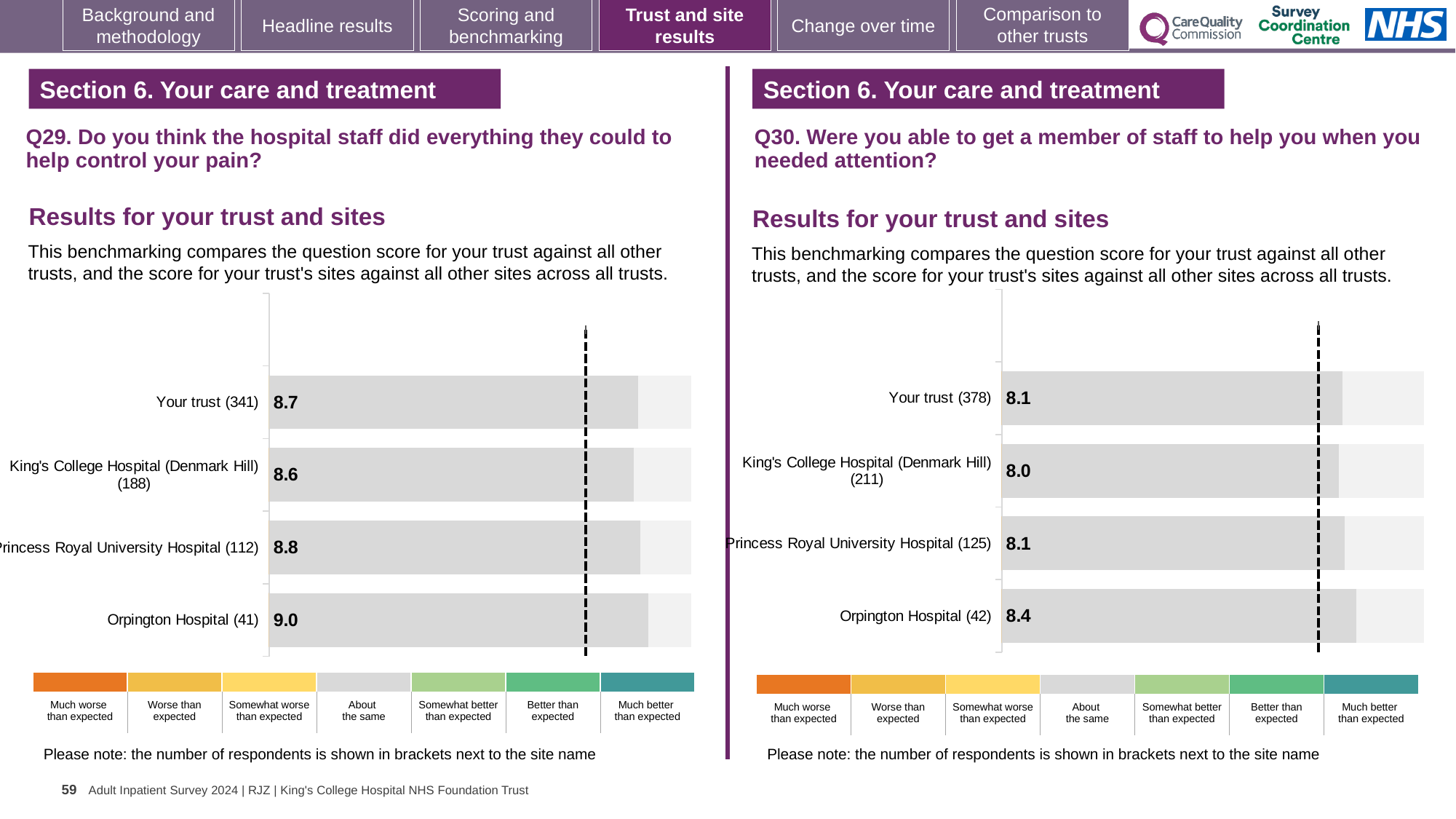
How many bars are plotted in the Q30 chart on the right? 4 In the Q29 chart on the left, which has the higher score, Princess Royal University Hospital or Your trust? Princess Royal University Hospital In the Q29 chart on the left, what is the difference between the scores for Orpington Hospital and King's College Hospital (Denmark Hill)? 0.4 In the Q30 chart on the right, which site or trust has the lowest score? King's College Hospital (Denmark Hill) In the Q29 chart on the left, what is the score for Your trust? 8.7 In the Q29 chart on the left, what is the score for Orpington Hospital? 9.0 In the Q30 chart on the right, what is the difference between the scores for Orpington Hospital and Your trust? 0.3 In the Q30 chart on the right, what is the score for Orpington Hospital? 8.4 What kind of chart is used for the Q29 results on the left? Bar chart In the Q29 chart on the left, which site or trust has the lowest score? King's College Hospital (Denmark Hill) In the Q29 chart on the left, which site or trust has the highest score? Orpington Hospital In the Q30 chart on the right, what is the score for King's College Hospital (Denmark Hill)? 8.0